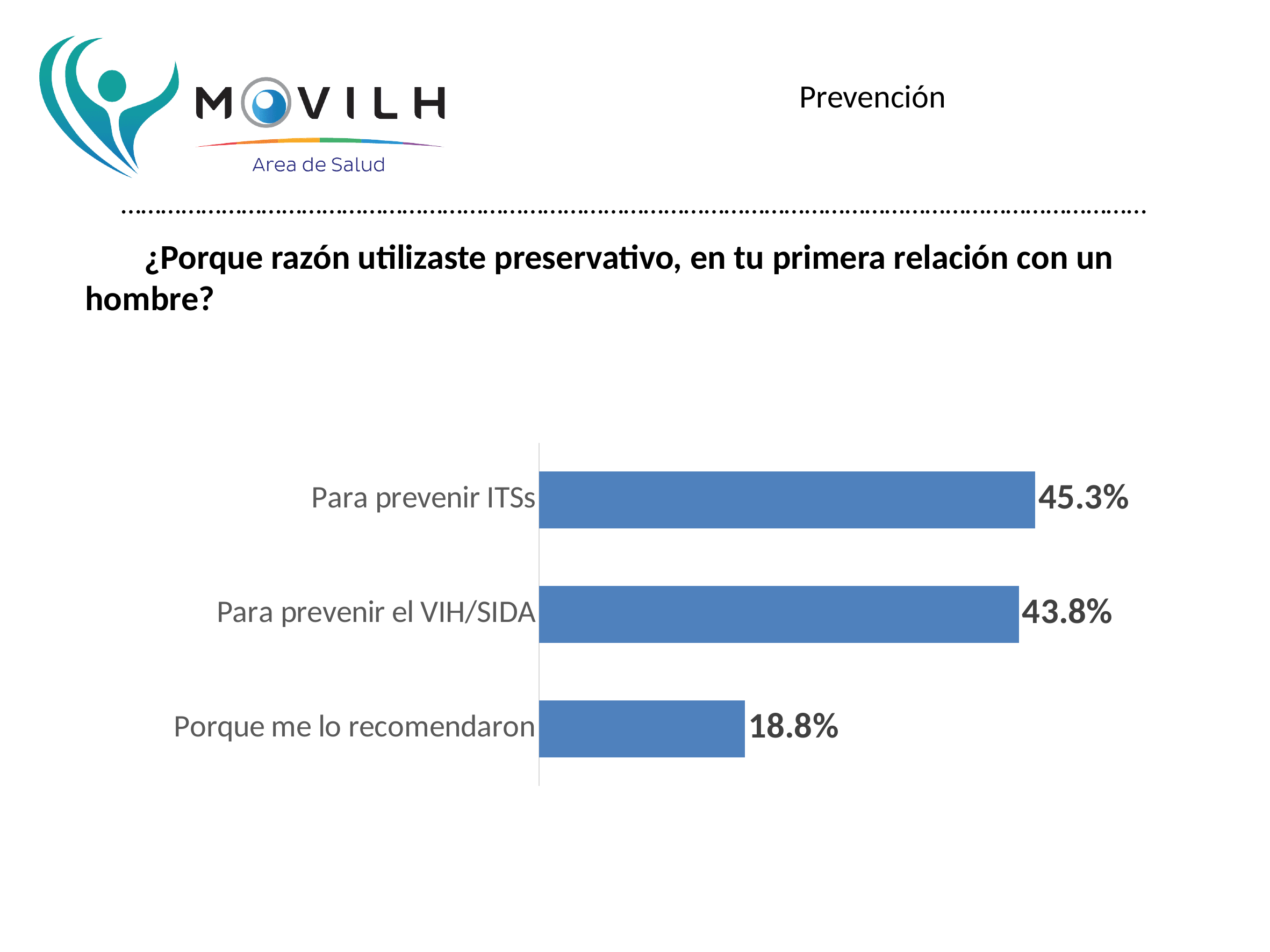
What is the value for "Para prevenir el VIH/SIDA"? 43.8% Which category has the lowest value? Porque me lo recomendaron What kind of chart is shown on the slide? Bar chart Which is larger: the value for "Para prevenir el VIH/SIDA" or for "Porque me lo recomendaron"? Para prevenir el VIH/SIDA What is the difference between the values for "Para prevenir ITSs" and "Porque me lo recomendaron"? 26.5% What is the value for "Para prevenir ITSs"? 45.3% How many categories does the chart show? 3 What question does the chart on the slide answer? ¿Porque razón utilizaste preservativo, en tu primera relación con un hombre? What is the value for "Porque me lo recomendaron"? 18.8% Which category has the highest value? Para prevenir ITSs What is the difference between the values for "Para prevenir ITSs" and "Para prevenir el VIH/SIDA"? 1.5% What is the total of the three values shown in the chart? 107.9%